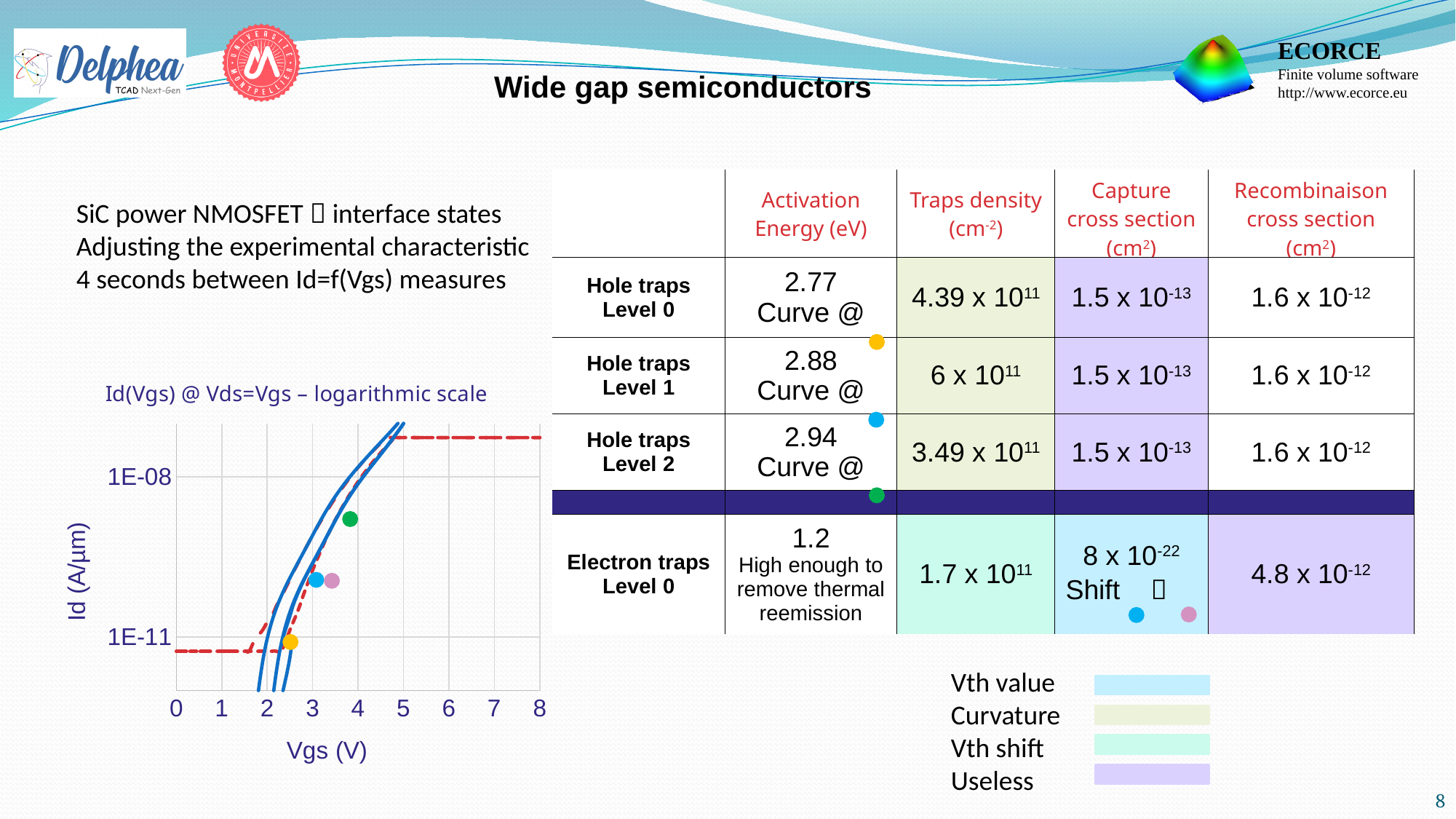
What is the y-axis label of the Id(Vgs) chart? Id (A/µm) How many coloured dot markers are shown on the Id(Vgs) chart? 4 In the Id(Vgs) chart, are the blue solid curves at Vgs = 4 V greater or less than 1E-11? greater What kind of chart is the Id(Vgs) @ Vds=Vgs chart on the slide? line chart How many tick values are labelled on the x axis of the Id(Vgs) chart? 9 In the Id(Vgs) chart, is the value of the red dashed curve at Vgs = 6 V greater or less than 1E-08? greater What is the title of the chart on the slide? Id(Vgs) @ Vds=Vgs – logarithmic scale In the Id(Vgs) chart, is the value of the red dashed curve at Vgs = 1 V greater or less than 1E-08? less In the Id(Vgs) chart, does Id rise or fall as Vgs increases along the x axis? rise How many solid blue curves are plotted in the Id(Vgs) chart? 3